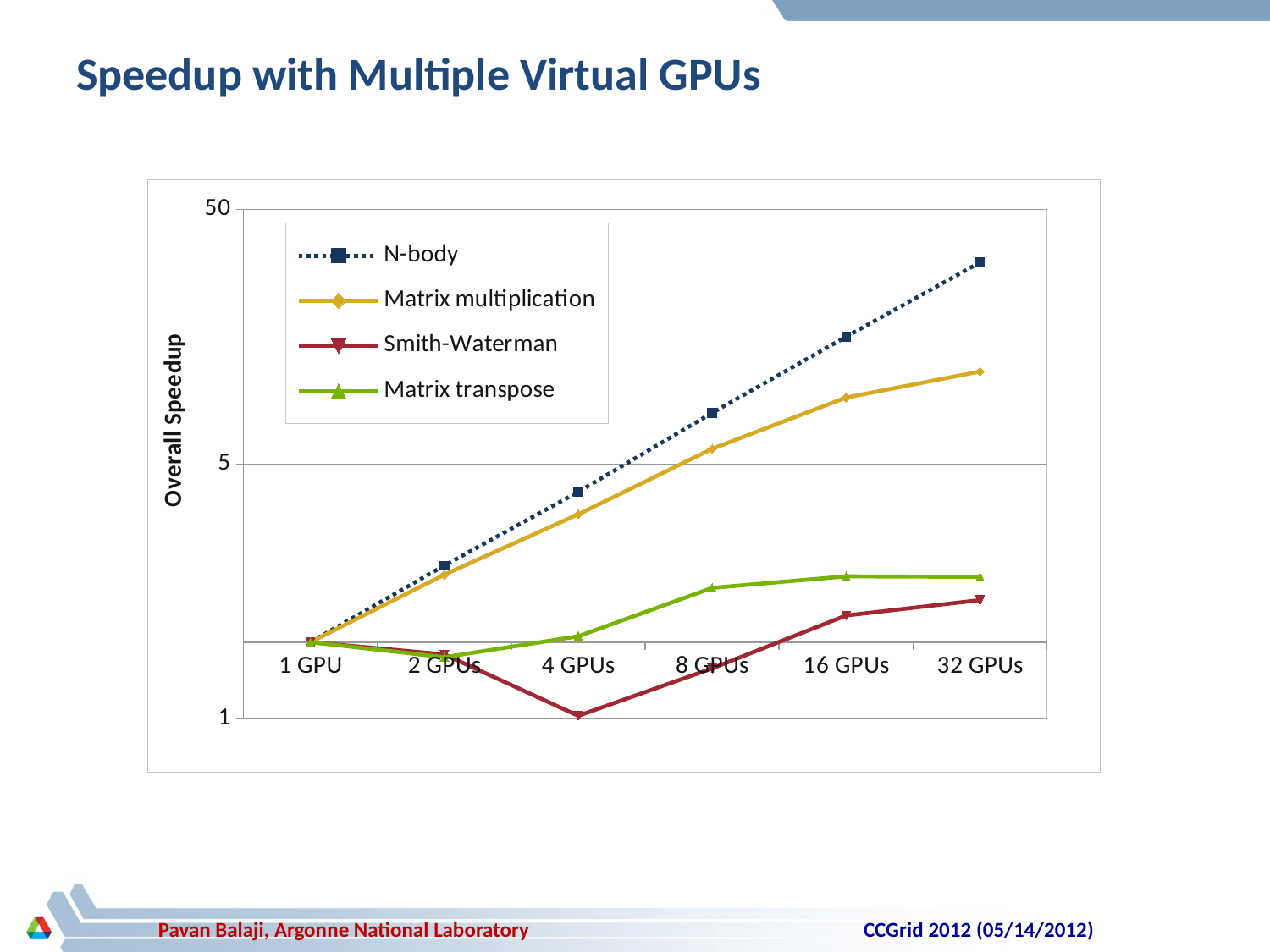
What kind of chart is shown on the slide? line chart Is the speedup for Matrix transpose at 32 GPUs greater or less than 5? less Which series has the lowest speedup at 32 GPUs? Smith-Waterman Does the N-body speedup rise or fall as the number of GPUs increases? rise Which series has the lowest speedup at 4 GPUs? Smith-Waterman How many series does the legend list? 4 At 8 GPUs, which is higher: Matrix transpose or Smith-Waterman? Matrix transpose Which series has the highest speedup at 32 GPUs? N-body At 16 GPUs, which is higher: N-body or Matrix multiplication? N-body Is the speedup for N-body at 32 GPUs greater or less than 5? greater How many GPU configurations are shown along the x axis? 6 What is the title of the y axis? Overall Speedup